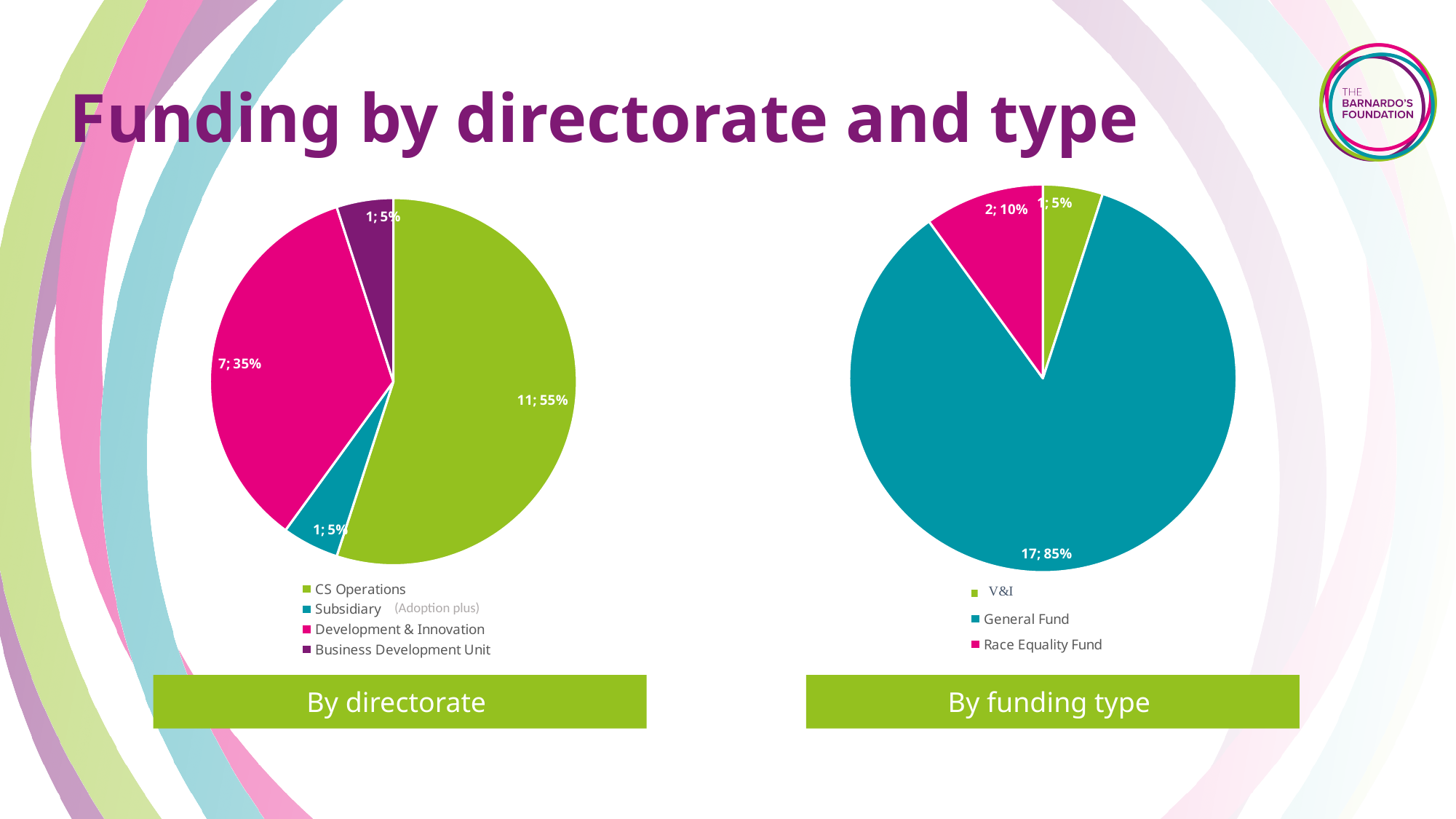
What type of chart is the 'By funding type' chart? Pie chart In the 'By funding type' chart, what colour is the General Fund slice? Teal In the 'By directorate' chart, which directorate has the largest slice? CS Operations In the 'By funding type' chart, what share of the pie does General Fund take? 85% In the 'By funding type' chart, which funding type has the smallest slice? V&I In the 'By funding type' chart, how many categories does the legend list? 3 In the 'By directorate' chart, what share of the pie does CS Operations take? 55% In the 'By directorate' chart, which is larger, Development & Innovation or Subsidiary? Development & Innovation In the 'By directorate' chart, what is the count shown for Development & Innovation? 7 In the 'By directorate' chart, what is the difference in count between CS Operations and Development & Innovation? 4 In the 'By directorate' chart, how many categories does the legend list? 4 In the 'By funding type' chart, what is the count shown for Race Equality Fund? 2